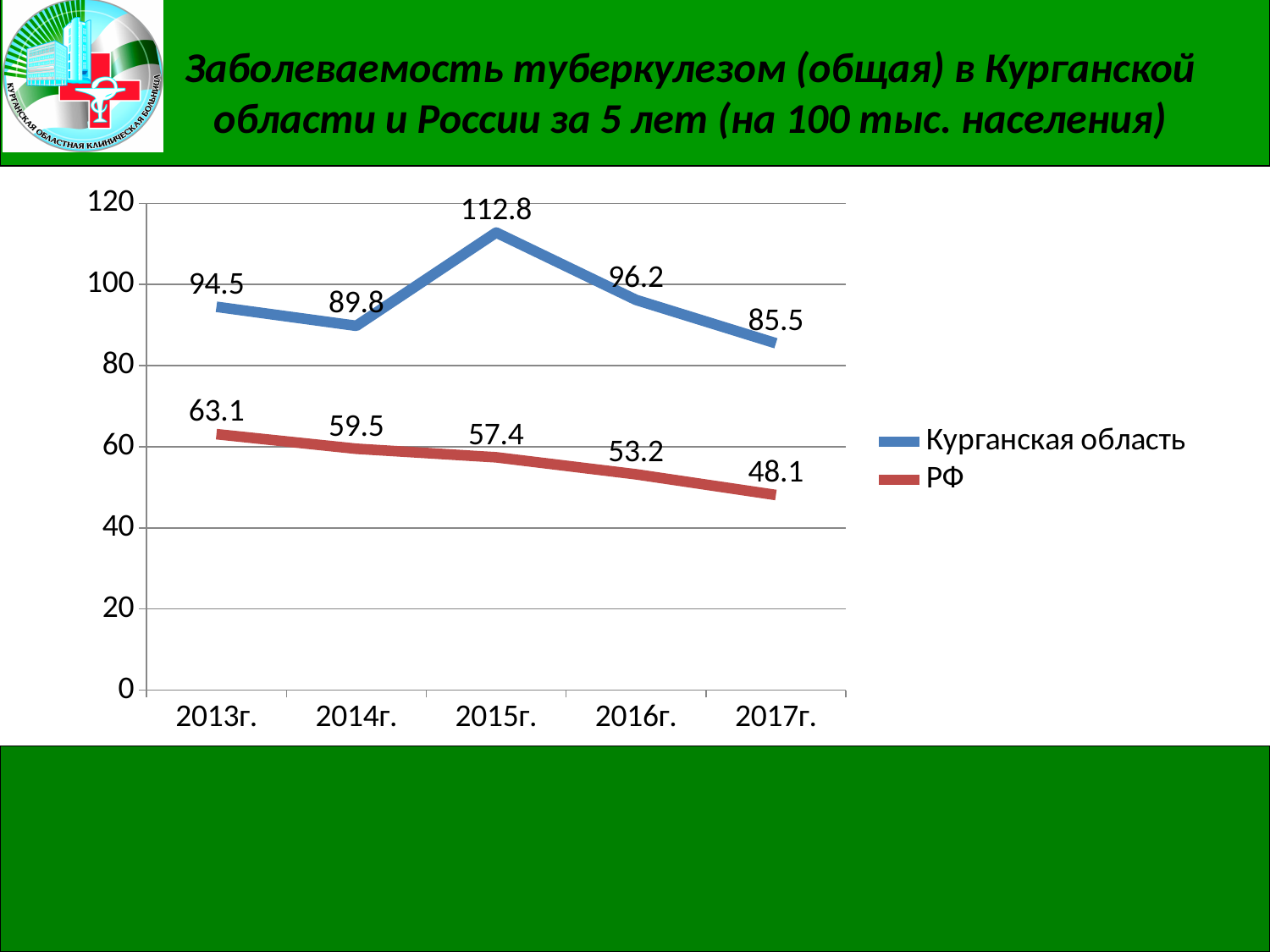
What is the value for Курганская область in 2015г.? 112.8 Does the value for РФ rise or fall from 2013г. to 2017г.? fall How many years are shown on the x axis? 5 What is the difference between the Курганская область and РФ values in 2017г.? 37.4 Which is larger in 2014г., the value for Курганская область or for РФ? Курганская область What colour is the line for РФ? red What type of chart is shown on the slide? line chart How many series does the legend list? 2 In which year is the value for РФ lowest? 2017г. What is the value for РФ in 2017г.? 48.1 What is the value for Курганская область in 2013г.? 94.5 In which year is the value for Курганская область highest? 2015г.